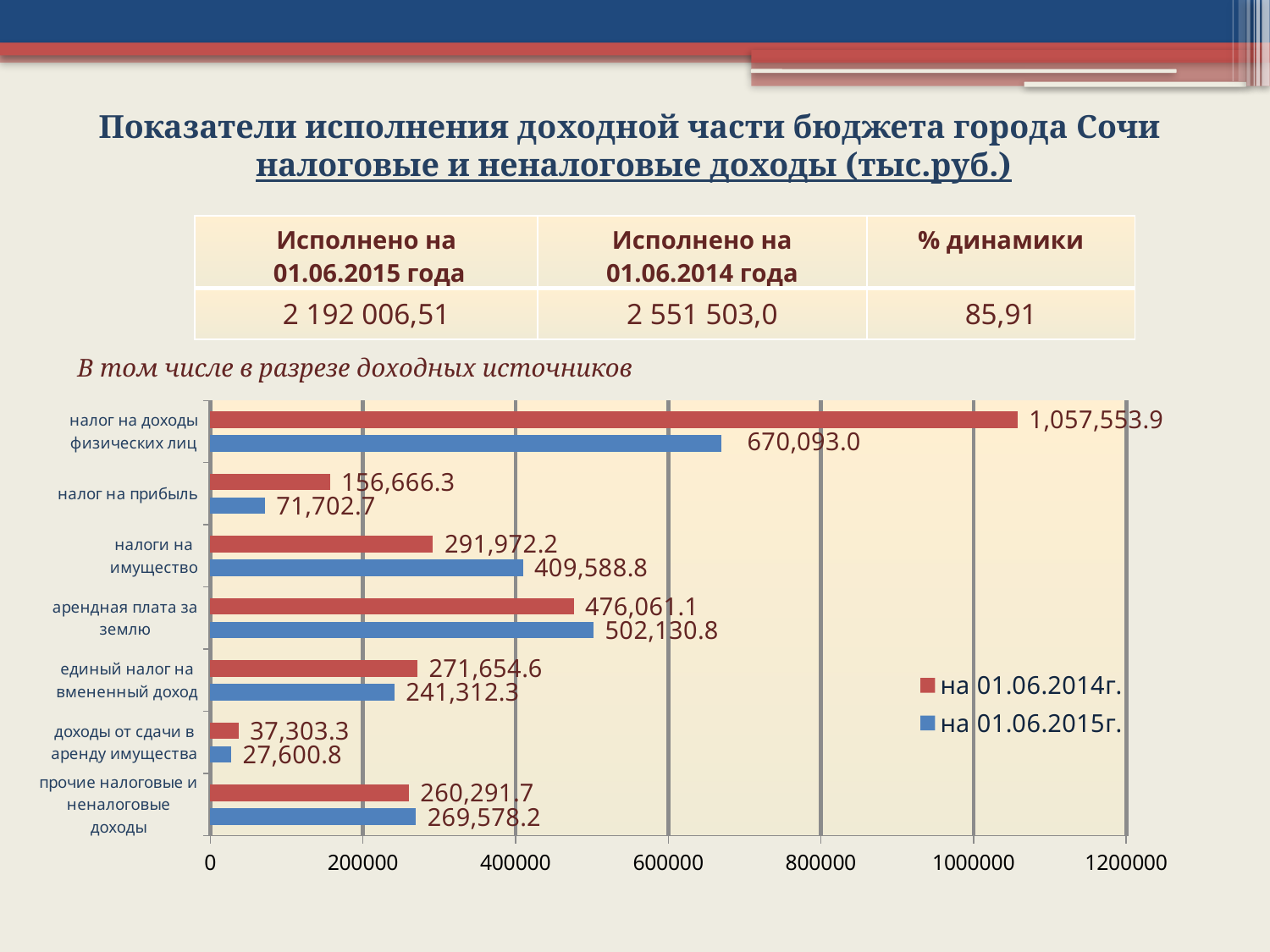
What is the value for налог на доходы физических лиц in the series на 01.06.2015г.? 670,093.0 For налоги на имущество, which series has the larger value: на 01.06.2014г. or на 01.06.2015г.? на 01.06.2015г. What is the value for доходы от сдачи в аренду имущества in the series на 01.06.2014г.? 37,303.3 Which colour represents the series на 01.06.2015г. in the chart? blue What is the value for налоги на имущество in the series на 01.06.2015г.? 409,588.8 Which category has the lowest value in the series на 01.06.2015г.? доходы от сдачи в аренду имущества What is the value for налог на доходы физических лиц in the series на 01.06.2014г.? 1,057,553.9 What type of chart is shown on the slide? bar chart How many series does the chart legend list? 2 What is the difference between the на 01.06.2014г. and на 01.06.2015г. values for налог на прибыль? 84,963.6 Which category has the highest value in the series на 01.06.2014г.? налог на доходы физических лиц How many categories are shown on the chart? 7